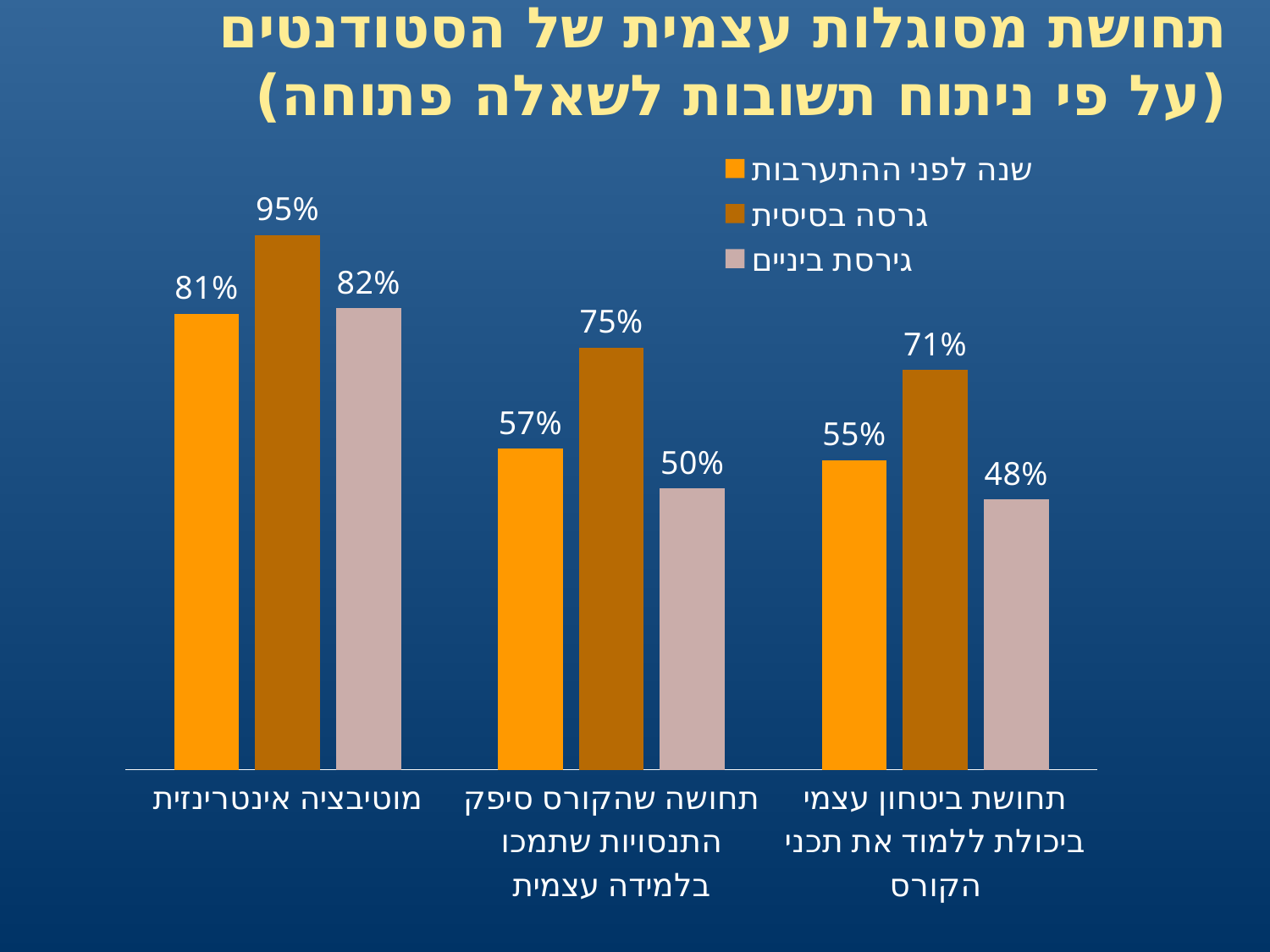
What kind of chart is shown on the slide? Bar chart What is the value for "גרסה בסיסית" in the "מוטיבציה אינטרינזית" category? 95% How many series does the legend list? 3 Which series is shown in orange in the legend? שנה לפני ההתערבות Which category has the highest value for the "גרסה בסיסית" series? מוטיבציה אינטרינזית What is the difference between the "גרסה בסיסית" and "גירסת ביניים" values in the "מוטיבציה אינטרינזית" category? 13% How many categories are shown on the x axis? 3 Which category has the lowest value for the "גירסת ביניים" series? תחושת ביטחון עצמי ביכולת ללמוד את תכני הקורס What is the difference between the "גרסה בסיסית" and "שנה לפני ההתערבות" values in the "תחושה שהקורס סיפק התנסויות שתמכו בלמידה עצמית" category? 18% What is the value for "שנה לפני ההתערבות" in the "תחושת ביטחון עצמי ביכולת ללמוד את תכני הקורס" category? 55% In the "תחושת ביטחון עצמי ביכולת ללמוד את תכני הקורס" category, which is larger: "שנה לפני ההתערבות" or "גירסת ביניים"? שנה לפני ההתערבות What is the value for "גירסת ביניים" in the "תחושה שהקורס סיפק התנסויות שתמכו בלמידה עצמית" category? 50%